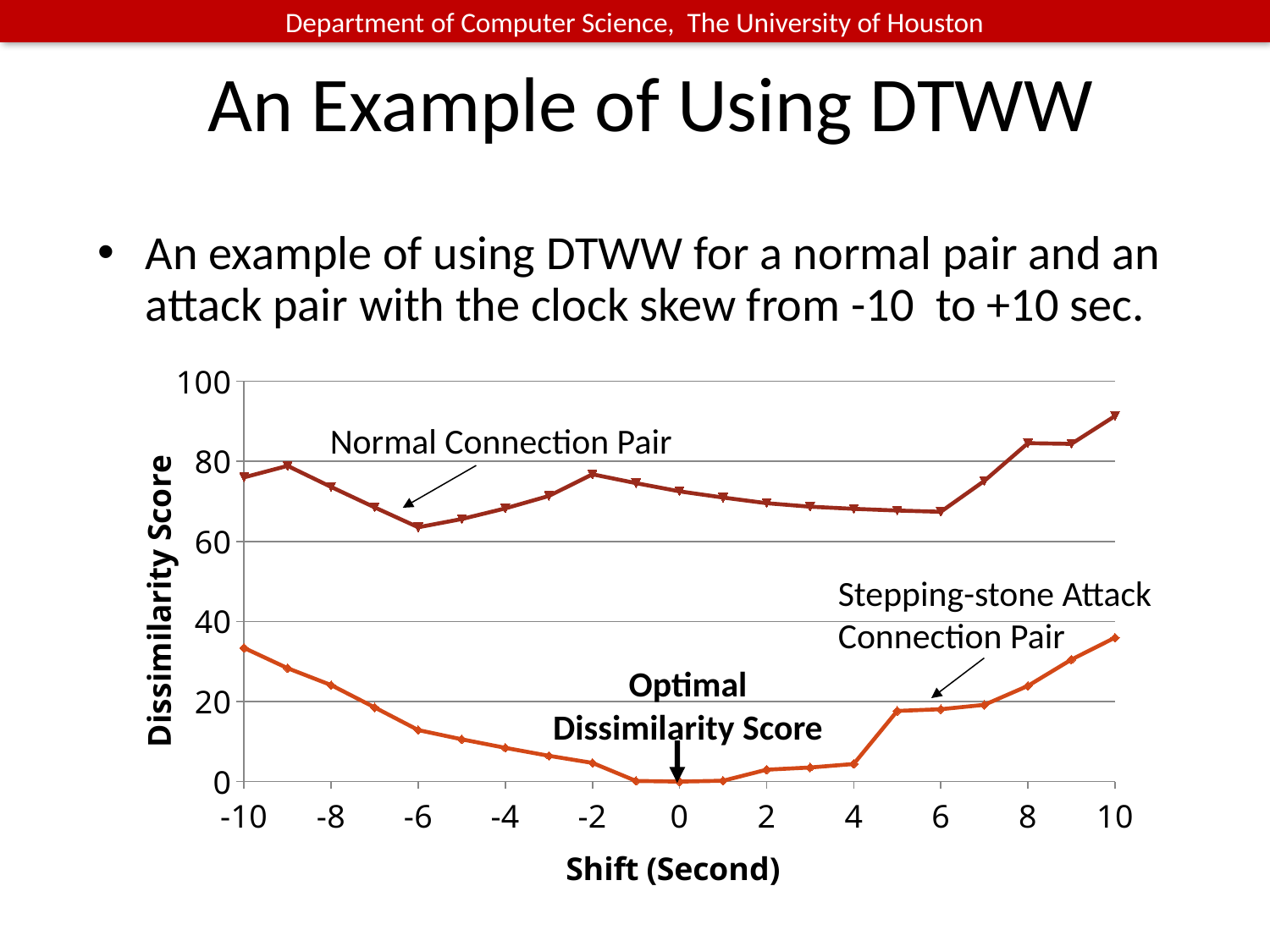
What is the title of the y axis? Dissimilarity Score Is the Stepping-stone Attack Connection Pair value at shift -10 greater or less than 40? less At which shift does the Normal Connection Pair reach its highest dissimilarity score? 10 How many shift values are plotted along the x axis? 21 At shift 0, which series has the higher dissimilarity score, the Normal Connection Pair or the Stepping-stone Attack Connection Pair? Normal Connection Pair Is the Normal Connection Pair value at shift 10 greater or less than 80? greater What is the title of the x axis? Shift (Second) What kind of chart is shown on the slide? line chart How many data series are plotted on the chart? 2 Is the Normal Connection Pair value at shift -6 greater or less than 60? greater Does the Stepping-stone Attack Connection Pair rise or fall as the shift goes from 5 to 10? rise